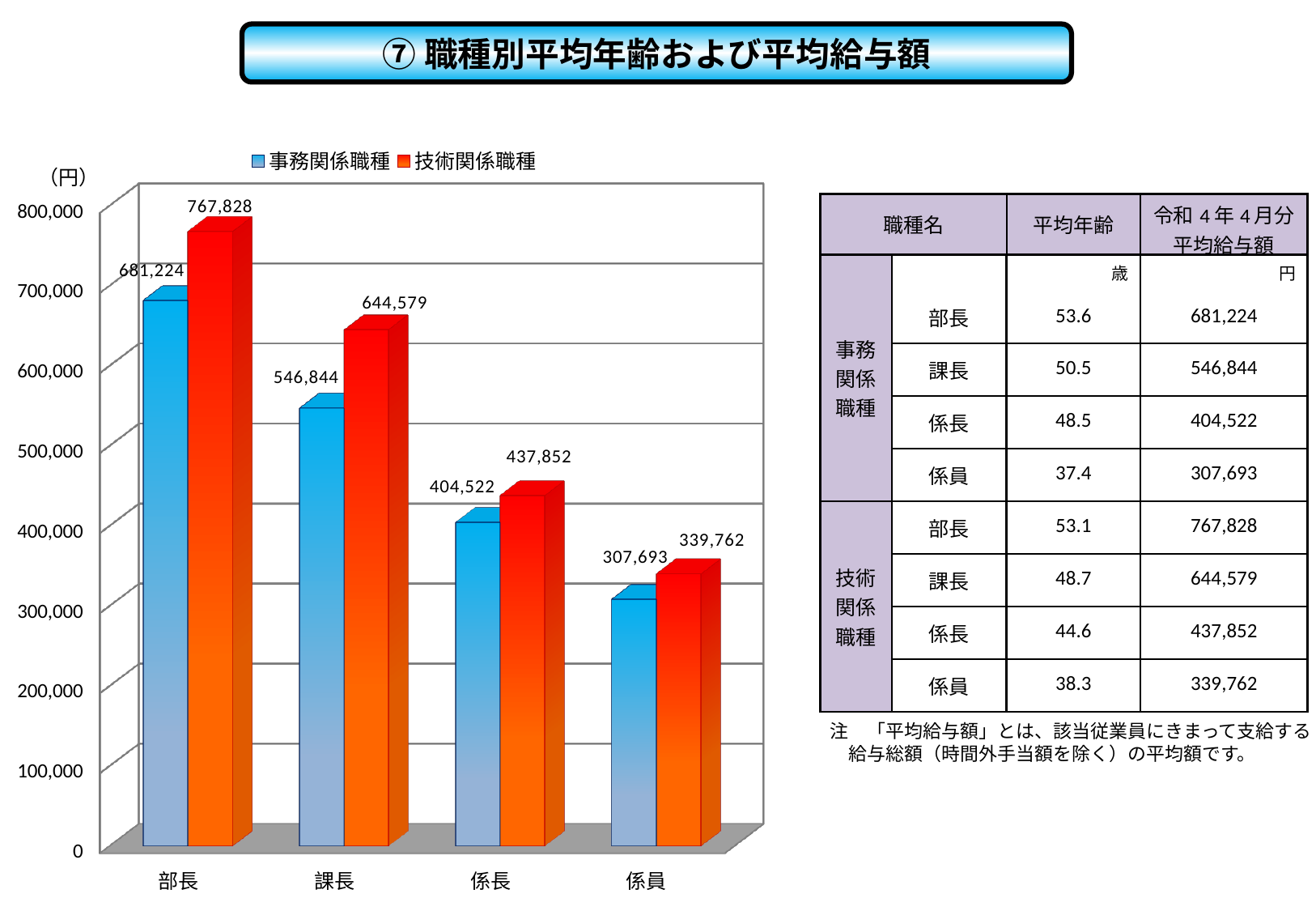
What is the value for 部長 in the 事務関係職種 series? 681,224 What is the difference between the 技術関係職種 and 事務関係職種 values for 部長? 86,604 How many series does the legend list? 2 What is the value for 課長 in the 技術関係職種 series? 644,579 How many categories are shown on the x axis? 4 Which category has the lowest value in the 事務関係職種 series? 係員 Do the 事務関係職種 values rise or fall from 部長 to 係員 along the x axis? fall Which is larger for 係長: the 事務関係職種 value or the 技術関係職種 value? 技術関係職種 What is the value for 係員 in the 事務関係職種 series? 307,693 Is the 技術関係職種 value for 係員 greater or less than 300,000? greater What kind of chart is shown on the slide? bar chart Which category has the highest value in the 技術関係職種 series? 部長